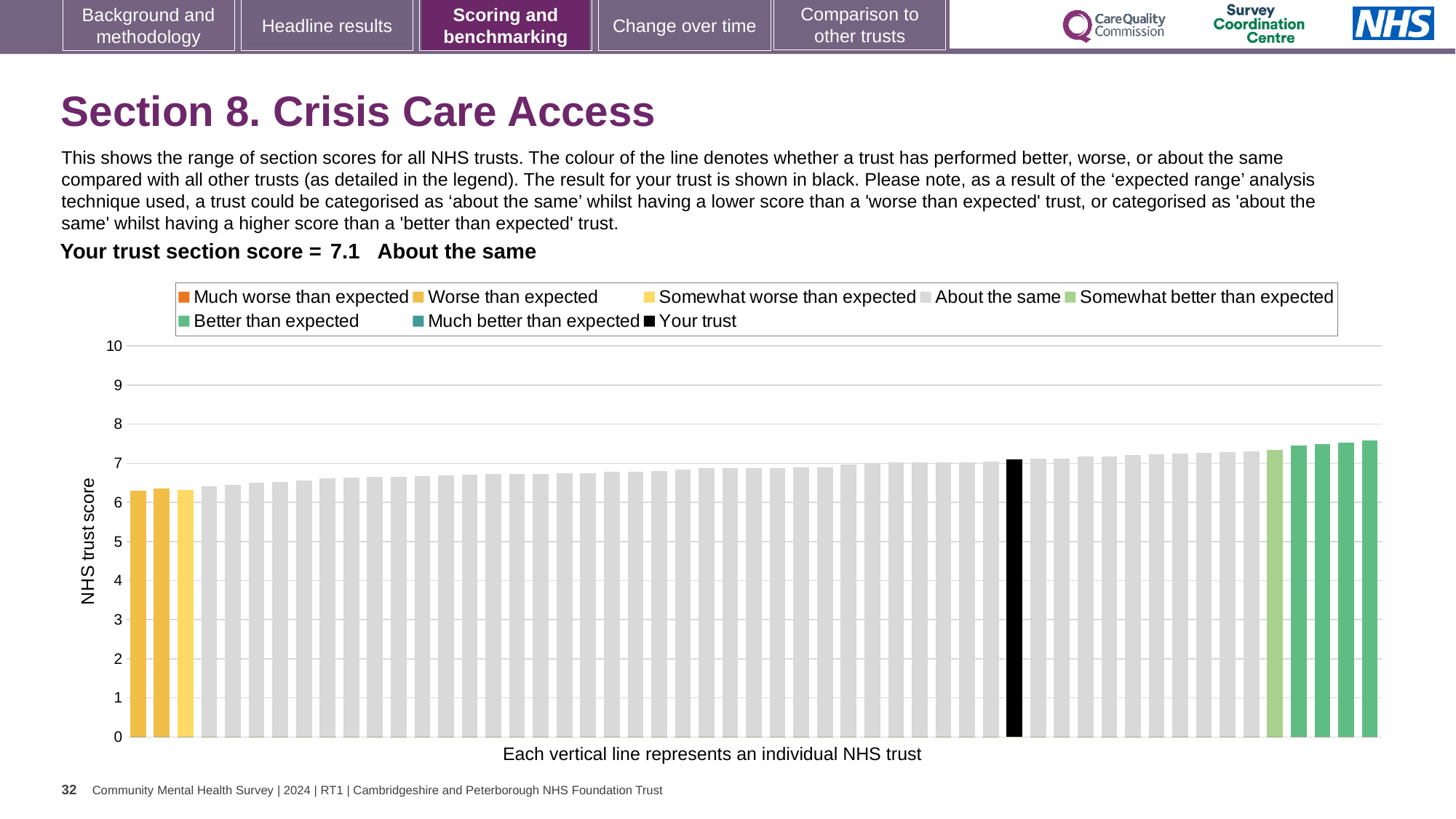
What kind of chart is shown on the slide? bar chart What is the label on the vertical axis of the chart? NHS trust score How many entries does the chart legend list? 8 How many bars are coloured as 'Better than expected' (the darker green bars)? 4 Which performance category is your trust placed in for Crisis Care Access? About the same Is the value for the rightmost (highest) bar greater or less than 7? greater Is the value for the leftmost (lowest) bar greater or less than 6? greater Is the value for the leftmost (lowest) bar greater or less than 7? less How many bars are coloured as 'Worse than expected' (the darker yellow bars)? 2 Do the bar values rise or fall from left to right along the x axis? rise What is the section score for your trust shown on the slide? 7.1